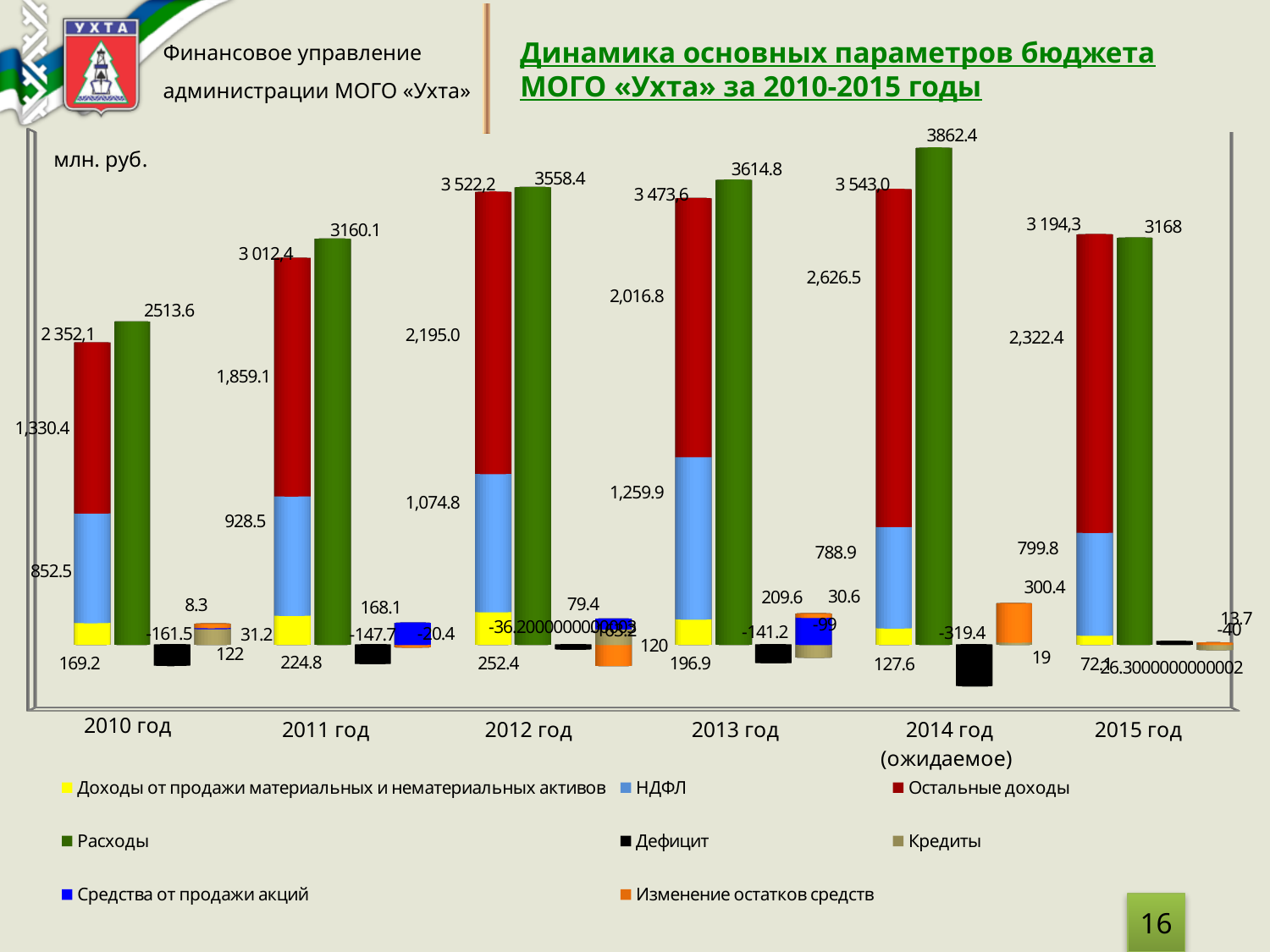
What is the value of Расходы for 2014 год (ожидаемое)? 3862.4 What is the value of НДФЛ for 2013 год? 1,259.9 What is the value of Дефицит for 2010 год? -161.5 Which is larger, НДФЛ in 2012 год or НДФЛ in 2013 год? 2013 год What is the difference between Расходы in 2014 год (ожидаемое) and 2013 год? 247.6 How many series does the legend list? 8 What is the value of Доходы от продажи материальных и нематериальных активов for 2012 год? 252.4 What kind of chart is shown on the slide? bar chart In which year is Расходы the highest? 2014 год (ожидаемое) How many years are shown on the x axis? 6 Does Расходы rise or fall from 2010 год to 2014 год (ожидаемое)? rise In which year is Расходы the lowest? 2010 год